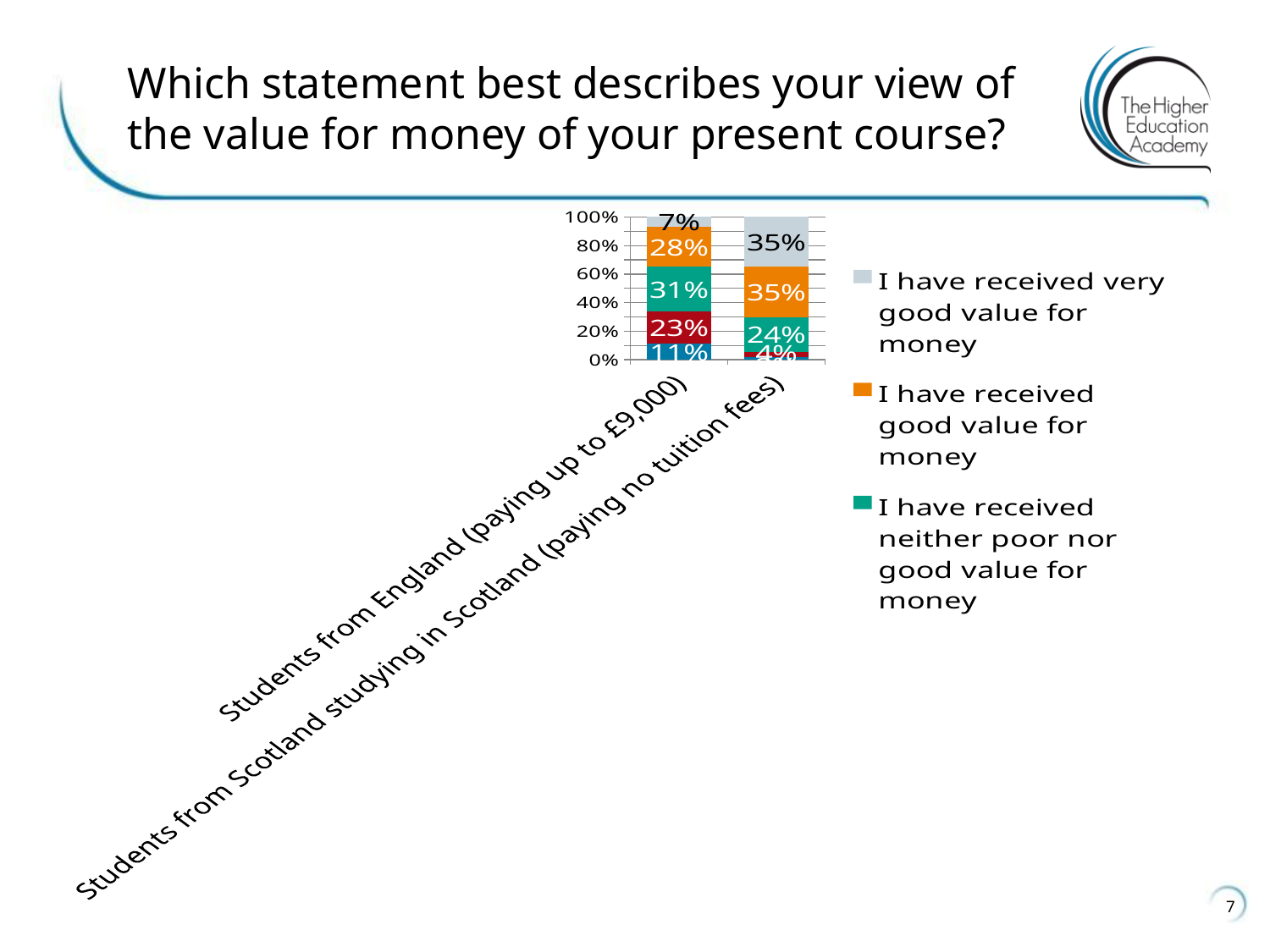
Which legend entry is shown in orange? I have received good value for money Which student group has the larger share saying they received very good value for money? Students from Scotland studying in Scotland (paying no tuition fees) What kind of chart is shown on the slide? Stacked bar chart What is the difference between the 'very good value for money' shares for students from Scotland and students from England? 28% What percentage of students from England (paying up to £9,000) said they have received neither poor nor good value for money? 31% How many series does the legend list? 3 What percentage of students from England (paying up to £9,000) said they have received good value for money? 28% What percentage of students from Scotland studying in Scotland (paying no tuition fees) said they have received very good value for money? 35% What percentage of students from Scotland studying in Scotland said they have received good value for money? 35% How many student groups (categories) are plotted on the x axis? 2 What percentage of students from Scotland studying in Scotland said they have received neither poor nor good value for money? 24% What percentage of students from England (paying up to £9,000) said they have received very good value for money? 7%